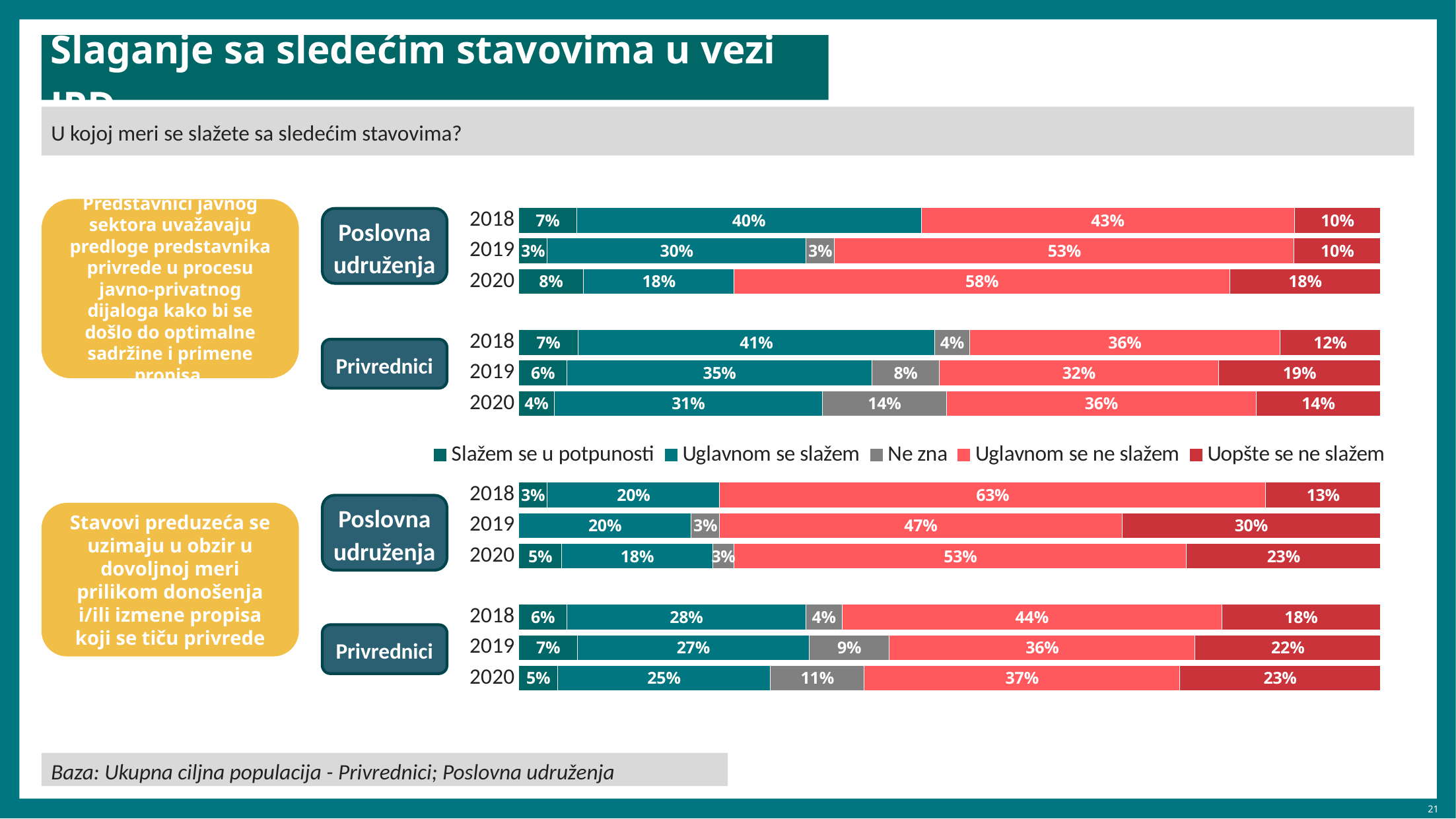
In the bottom chart, what is the combined share of 'Slažem se u potpunosti' and 'Uglavnom se slažem' for Privrednici in 2019? 34% How many years are shown for each respondent group in the charts? 3 In the top chart, by how many percentage points did the 'Uopšte se ne slažem' share for Privrednici change from 2018 to 2019? 7 percentage points What kind of chart is used on this slide? Stacked bar chart In the bottom chart, for Privrednici in 2020, which is larger: 'Uglavnom se ne slažem' or 'Uopšte se ne slažem'? Uglavnom se ne slažem How many series does the legend list? 5 In the top chart, what percentage of Poslovna udruženja in 2020 answered 'Uglavnom se ne slažem'? 58% In the bottom chart, what percentage of Privrednici in 2018 answered 'Uglavnom se slažem'? 28% In the bottom chart, in which year did Poslovna udruženja have the highest 'Uglavnom se ne slažem' share? 2018 In the top chart, what is the 'Ne zna' share for Privrednici in 2020? 14% In the bottom chart, what percentage of Poslovna udruženja in 2019 answered 'Uopšte se ne slažem'? 30% In the top chart, does the 'Uglavnom se slažem' share for Poslovna udruženja rise or fall from 2018 to 2020? Fall